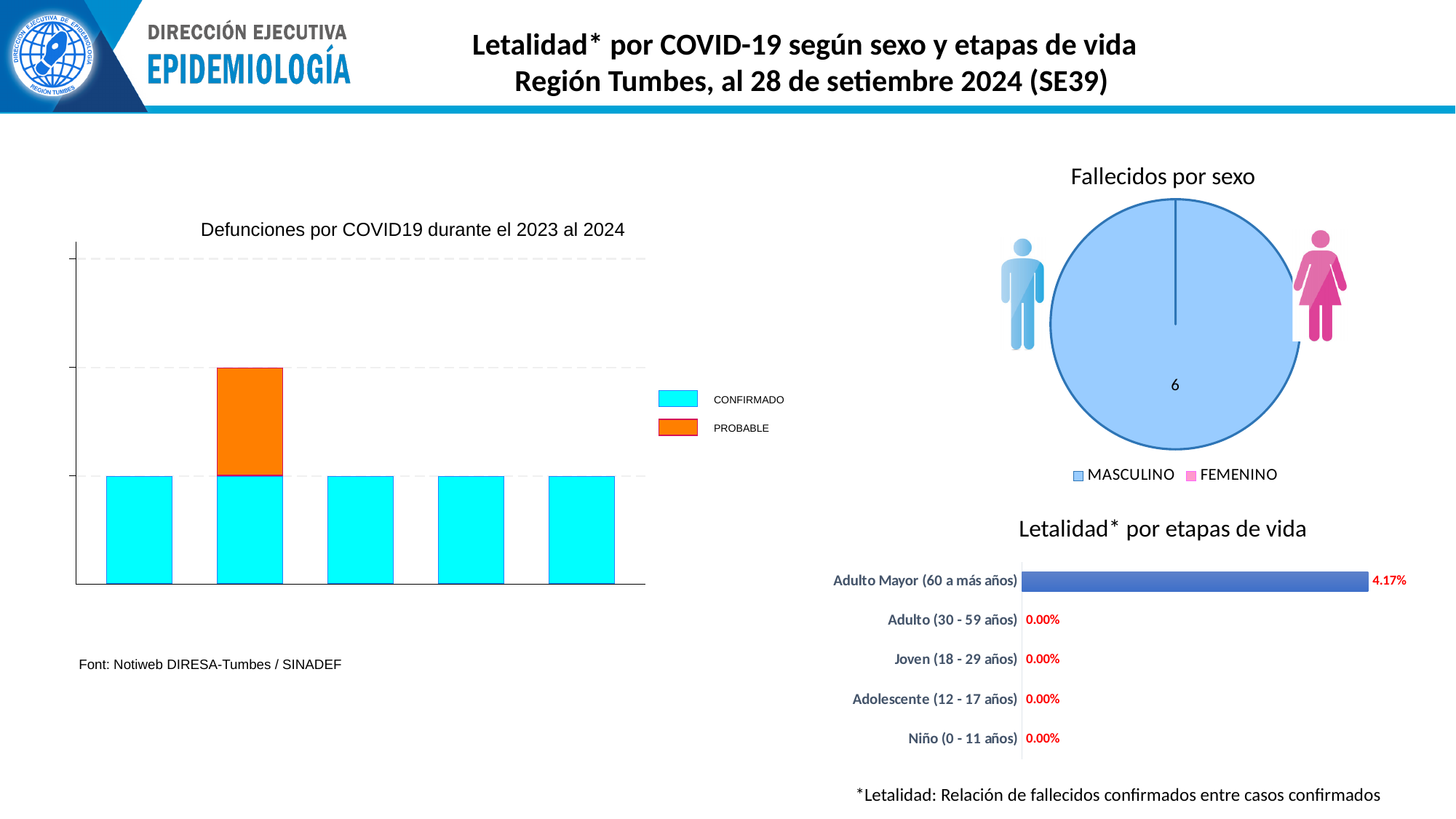
In the chart 'Letalidad* por etapas de vida', what is the value for Joven (18 - 29 años)? 0.00% In the chart 'Letalidad* por etapas de vida', which is larger, the value for Adulto Mayor (60 a más años) or the value for Niño (0 - 11 años)? Adulto Mayor (60 a más años) How many entries does the legend of the chart 'Fallecidos por sexo' list? 2 In the chart 'Letalidad* por etapas de vida', what is the difference between the values for Adulto Mayor (60 a más años) and Adulto (30 - 59 años)? 4.17% In the chart 'Letalidad* por etapas de vida', which category has the highest value? Adulto Mayor (60 a más años) In the chart 'Fallecidos por sexo', what value is shown for MASCULINO? 6 In the chart 'Letalidad* por etapas de vida', how many categories are shown? 5 In the chart 'Defunciones por COVID19 durante el 2023 al 2024', what are the two legend entries? CONFIRMADO and PROBABLE In the chart 'Defunciones por COVID19 durante el 2023 al 2024', how many series does the legend list? 2 In the chart 'Letalidad* por etapas de vida', what is the value for Adulto Mayor (60 a más años)? 4.17% What kind of chart is 'Letalidad* por etapas de vida'? Bar chart What kind of chart is 'Fallecidos por sexo'? Pie chart